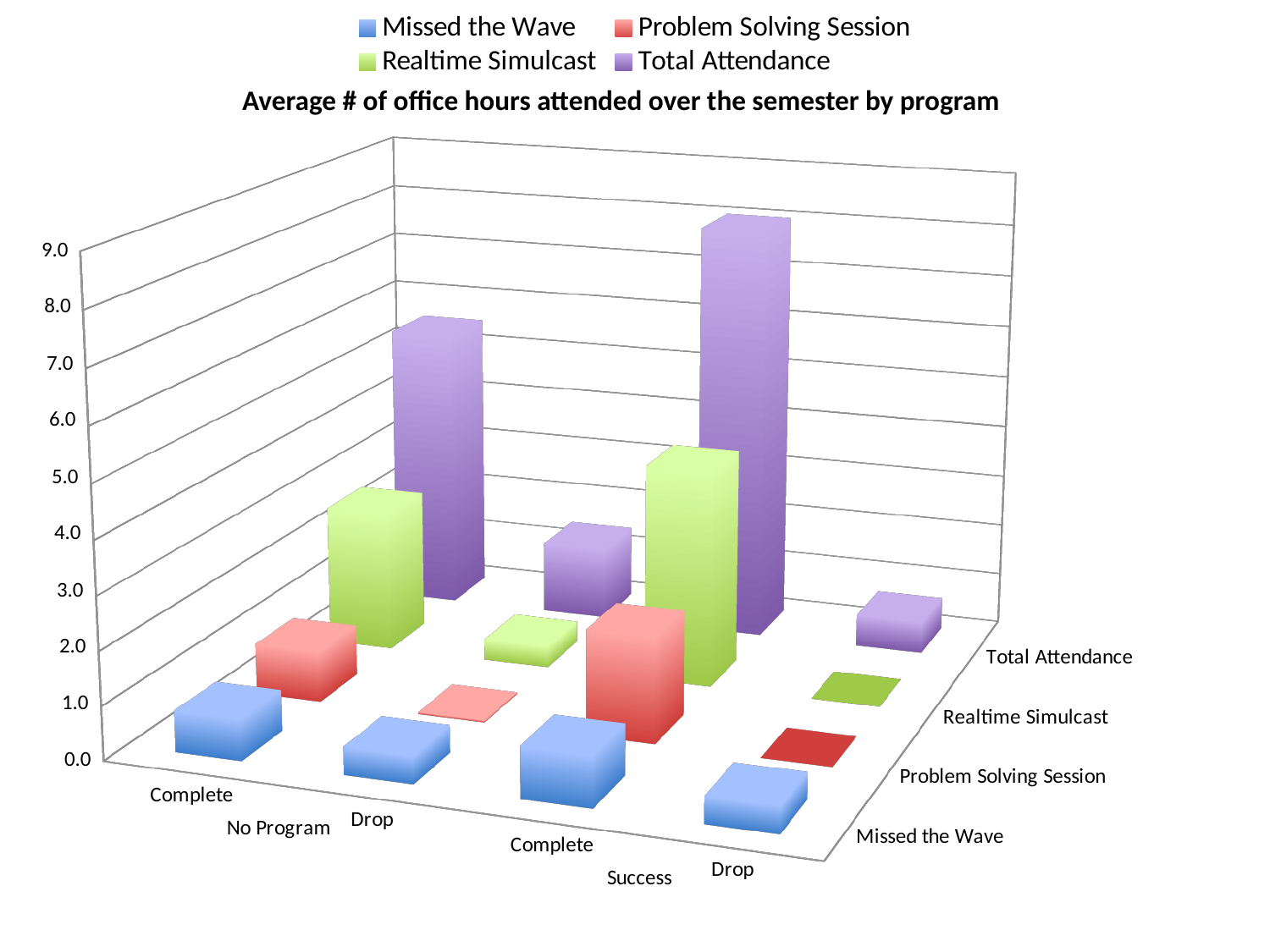
What is the title of the chart? Average # of office hours attended over the semester by program Which is larger: the Total Attendance value for Success Complete or for No Program Complete? Success Complete Which category has the highest Problem Solving Session value? Success Complete How many categories are plotted along the x axis? 4 Which colour represents the Total Attendance series in the legend? purple What kind of chart is shown on the slide? bar chart How many series does the legend list? 4 Which category has the highest Realtime Simulcast value? Success Complete Which category has the highest Total Attendance value? Success Complete Is the Realtime Simulcast value for Success Drop greater or less than 1.0? less Which category has the lowest Total Attendance value? Success Drop Is the Total Attendance value for Success Complete greater or less than 5.0? greater